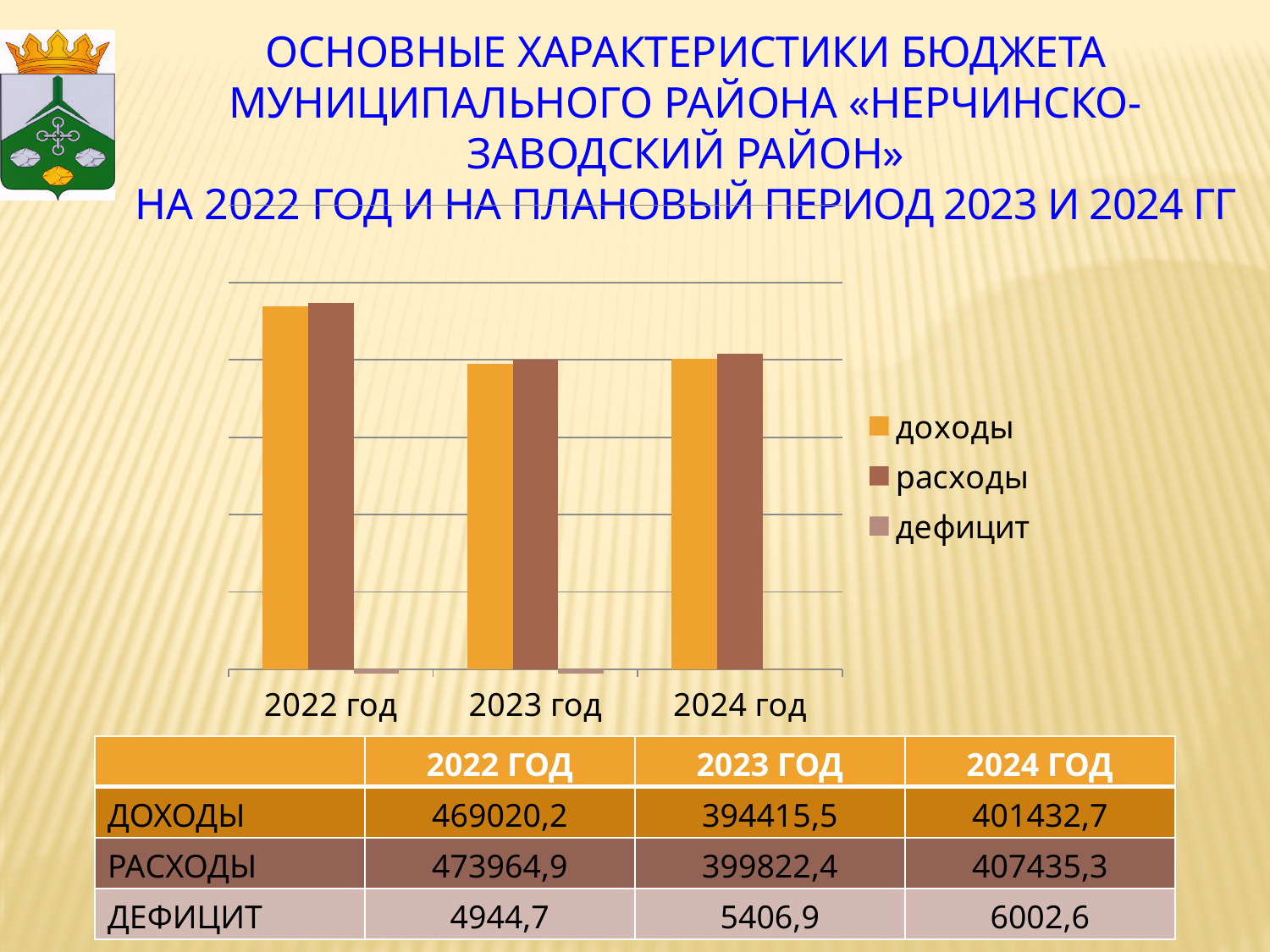
What kind of chart is shown on the slide? bar chart Do доходы rise or fall from 2022 год to 2023 год? fall For 2022 год, which is larger: доходы or расходы? расходы What is the value of доходы for 2022 год? 469020,2 How many series does the chart legend list? 3 In which year are доходы the highest? 2022 год In which year are расходы the lowest? 2023 год What is the difference between расходы and доходы for 2024 год? 6002,6 How many years (categories) are shown on the x axis of the chart? 3 Which series is shown in orange in the chart legend? доходы What is the value of дефицит for 2023 год? 5406,9 What is the value of расходы for 2024 год? 407435,3